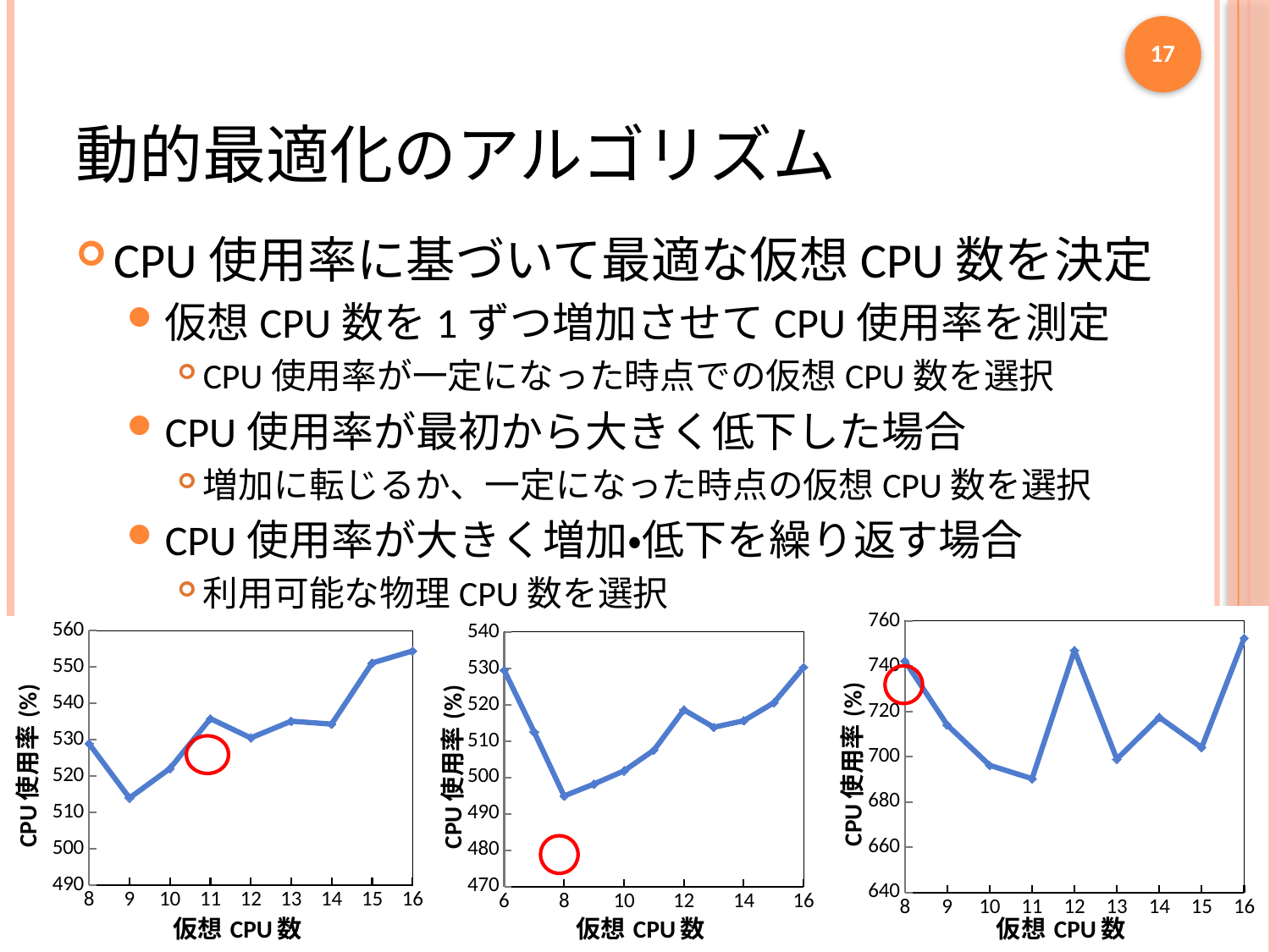
In the middle chart, which is larger: the value at 6 virtual CPUs or the value at 8 virtual CPUs? 6 virtual CPUs In the middle chart, at which number of virtual CPUs is the CPU usage lowest? 8 In the left chart, at which number of virtual CPUs (仮想 CPU 数) is the CPU usage lowest? 9 In the left chart, is the value at 9 virtual CPUs greater or less than 520? less In the right chart, what is the label of the y axis? CPU使用率 (%) In the middle chart, how many data points are plotted? 11 What kind of chart is the left chart on the slide? line chart In the right chart, which is larger: the value at 8 virtual CPUs or the value at 11 virtual CPUs? 8 virtual CPUs In the middle chart, is the value at 8 virtual CPUs greater or less than 500? less In the right chart, is the value at 11 virtual CPUs greater or less than 700? less In the left chart, what is the label of the x axis? 仮想 CPU 数 In the left chart, how many data points are plotted? 9